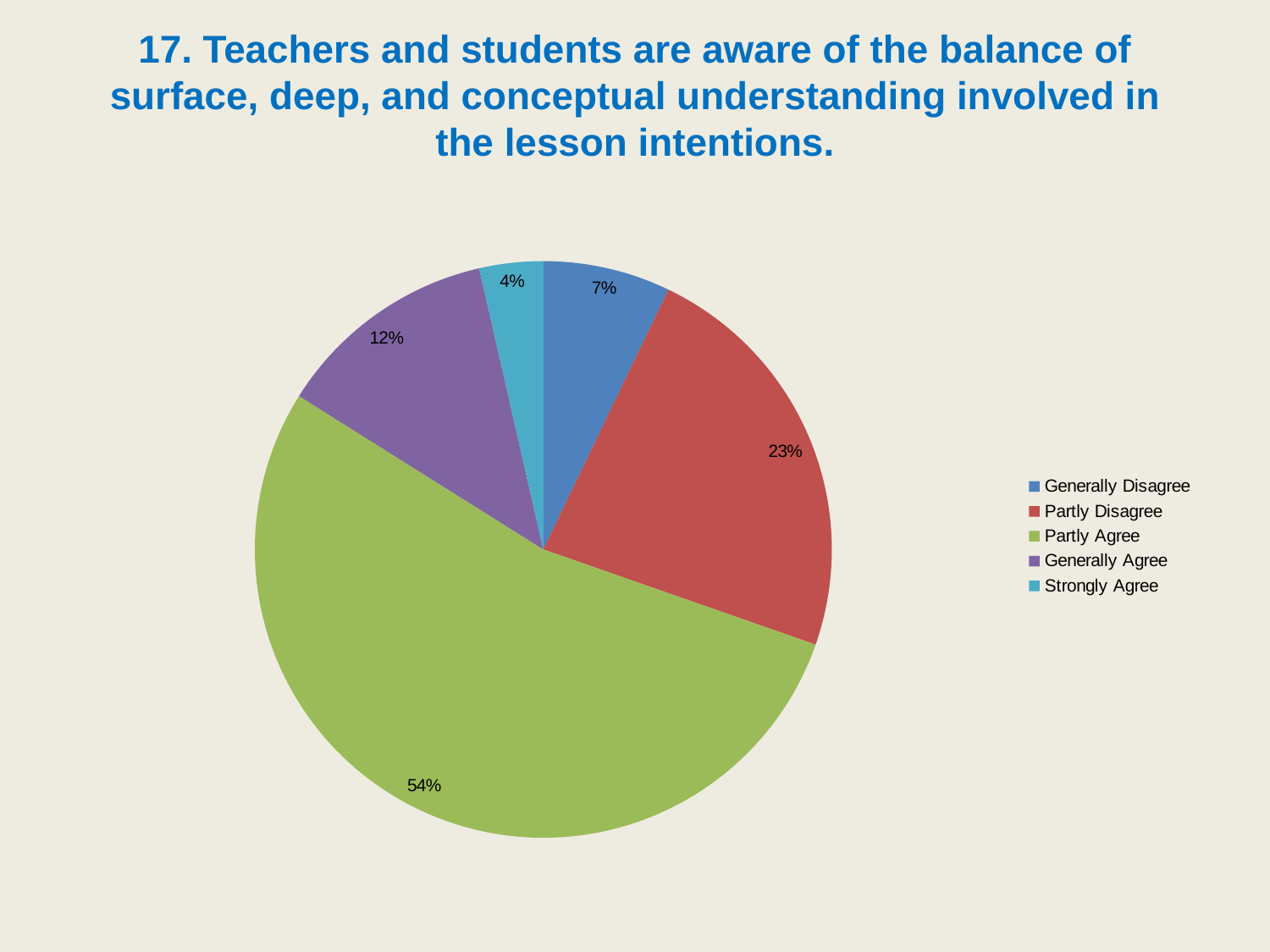
How many categories does the legend list? 5 What is the difference between the Partly Agree and Partly Disagree shares? 31% Which category has the largest slice of the pie? Partly Agree What kind of chart is shown on the slide? pie chart Which category has the smallest slice of the pie? Strongly Agree What share of the pie is Partly Disagree? 23% What colour is the Partly Agree slice? green What share of the pie is Strongly Agree? 4% What share of the pie is Partly Agree? 54% Which is larger, the Generally Agree slice or the Generally Disagree slice? Generally Agree